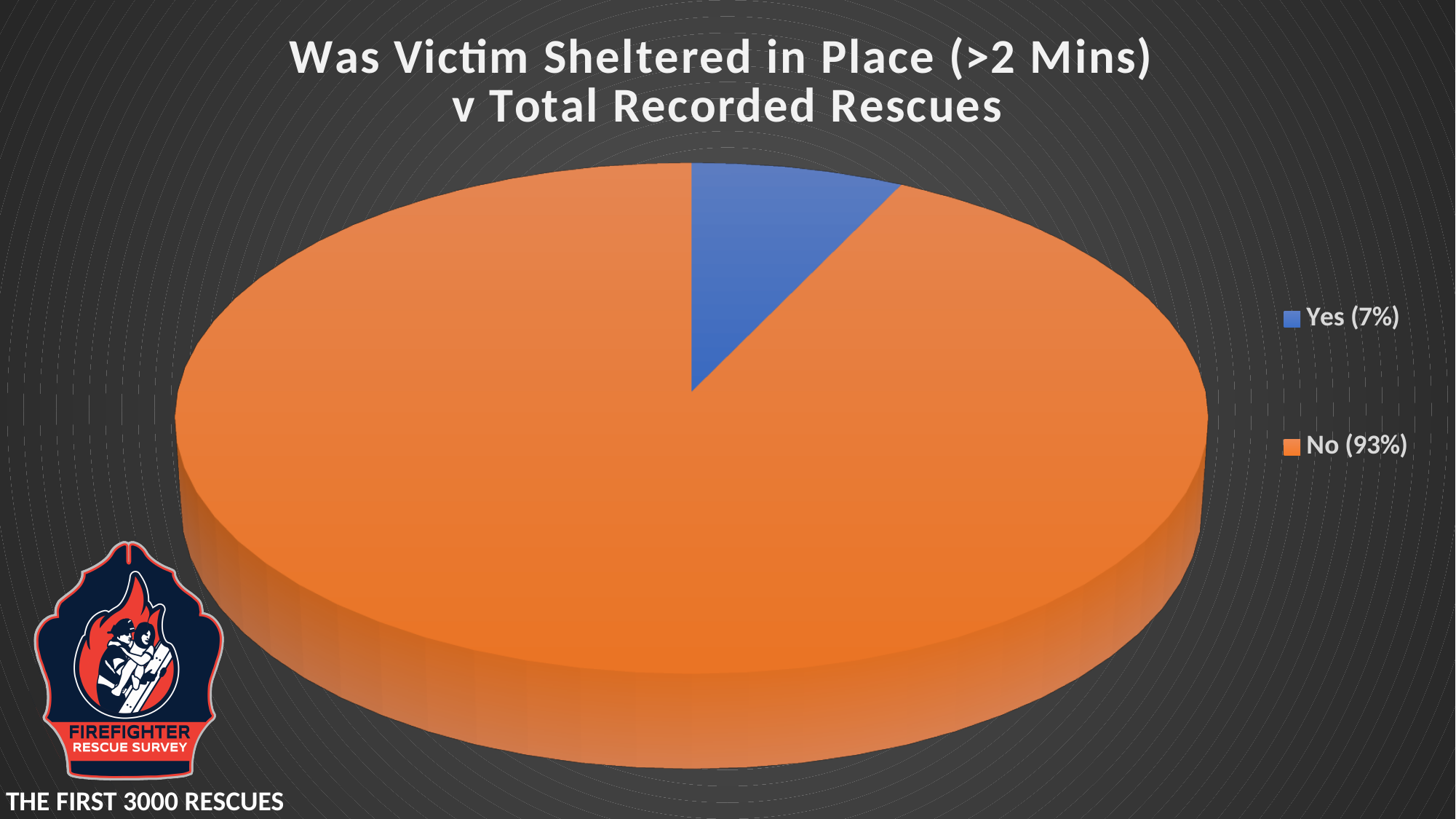
What share of the pie does the "Yes" slice represent? 7% What kind of chart is shown on the slide? pie chart Which category has the largest slice of the pie? No Which slice is larger, "Yes" or "No"? No Which category has the smallest slice of the pie? Yes How many categories does the pie chart show? 2 How many entries does the legend list? 2 What is the difference in percentage points between the "No" and "Yes" slices? 86 What is the title of the chart? Was Victim Sheltered in Place (>2 Mins) v Total Recorded Rescues What share of the pie does the "No" slice represent? 93% What colour is the "Yes" slice? blue